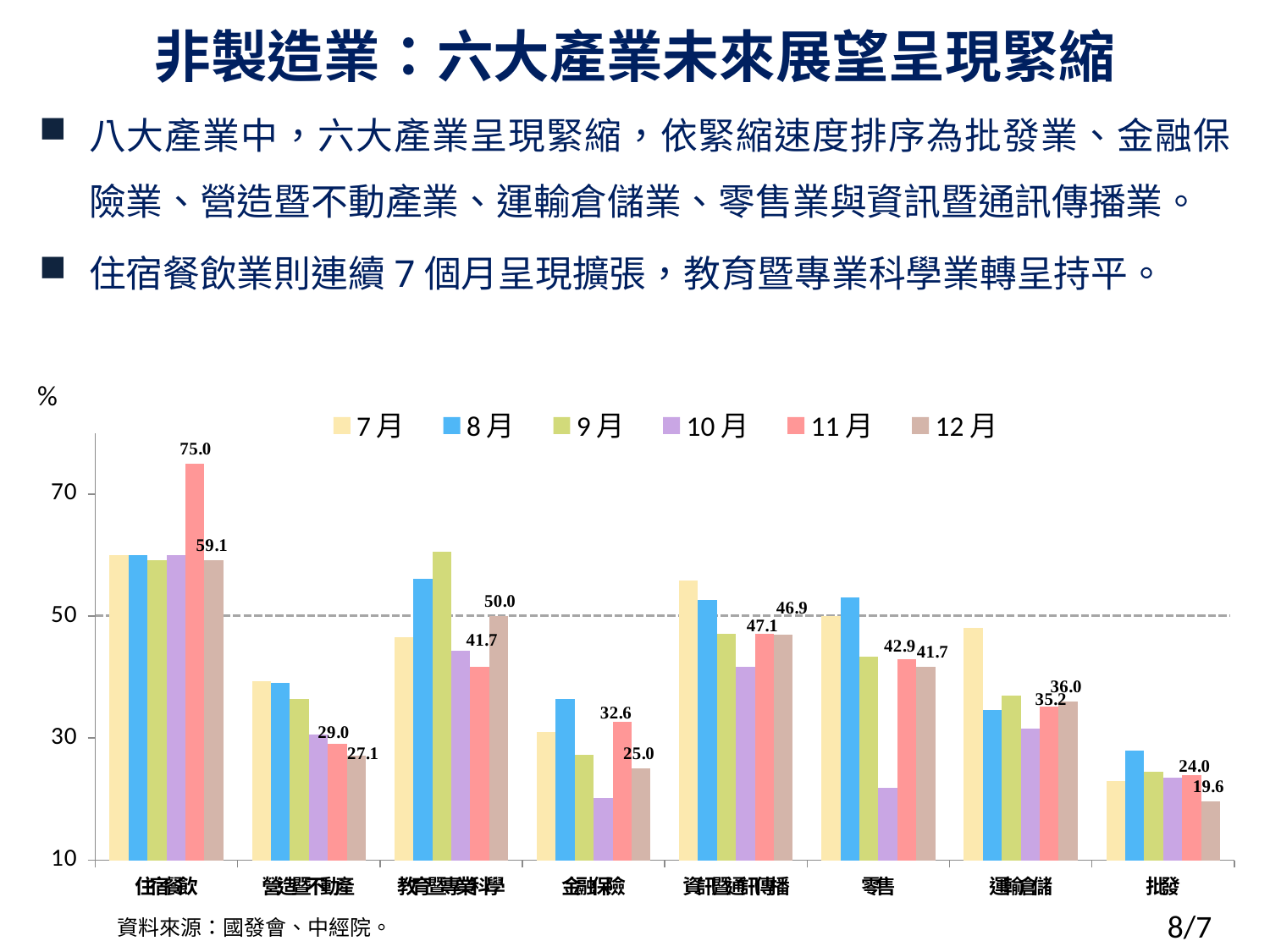
Is the 8月 value for 批發 greater or less than 30? less Which category has the highest value in the 12月 series? 住宿餐飲 What is the value for 批發 in the 12月 series? 19.6 How many series does the legend list? 6 What is the difference between the 11月 and 12月 values for 住宿餐飲? 15.9 What is the value for 住宿餐飲 in the 11月 series? 75.0 For 金融保險, which is larger: the 11月 value or the 12月 value? 11月 What kind of chart is shown on the slide? bar chart How many industry categories are shown on the x axis? 8 Which category has the lowest value in the 11月 series? 批發 Is the 7月 value for 資訊暨通訊傳播 greater or less than 50? greater What is the value for 教育暨專業科學 in the 12月 series? 50.0